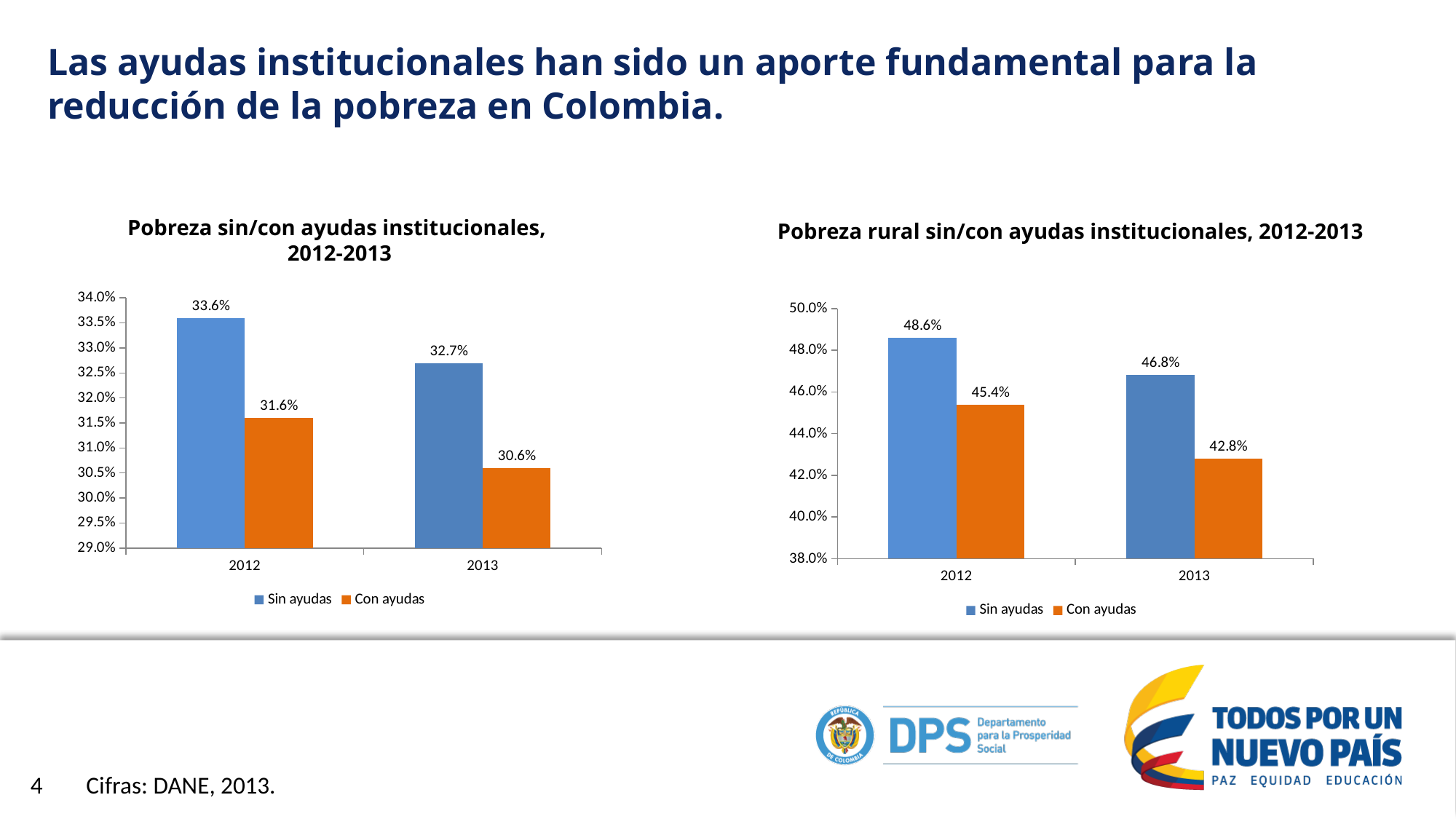
In the chart 'Pobreza rural sin/con ayudas institucionales, 2012-2013', what is the value for 'Con ayudas' in 2012? 45.4% In the chart 'Pobreza rural sin/con ayudas institucionales, 2012-2013', does the 'Sin ayudas' series rise or fall from 2012 to 2013? fall What kind of chart is 'Pobreza rural sin/con ayudas institucionales, 2012-2013'? bar chart In the chart 'Pobreza sin/con ayudas institucionales, 2012-2013', what is the value for 'Con ayudas' in 2013? 30.6% In the chart 'Pobreza sin/con ayudas institucionales, 2012-2013', what is the difference between 'Sin ayudas' and 'Con ayudas' in 2012? 2.0% In the chart 'Pobreza rural sin/con ayudas institucionales, 2012-2013', what is the value for 'Sin ayudas' in 2013? 46.8% In the chart 'Pobreza rural sin/con ayudas institucionales, 2012-2013', which bar is the highest? Sin ayudas, 2012 How many series does the legend of the chart 'Pobreza sin/con ayudas institucionales, 2012-2013' list? 2 In the chart 'Pobreza rural sin/con ayudas institucionales, 2012-2013', what is the difference between 'Sin ayudas' and 'Con ayudas' in 2013? 4.0% In the chart 'Pobreza sin/con ayudas institucionales, 2012-2013', what is the value for 'Sin ayudas' in 2012? 33.6% In the chart 'Pobreza sin/con ayudas institucionales, 2012-2013', which bar is the lowest? Con ayudas, 2013 In the chart 'Pobreza sin/con ayudas institucionales, 2012-2013', which is larger: 'Con ayudas' in 2012 or 'Sin ayudas' in 2013? Sin ayudas in 2013